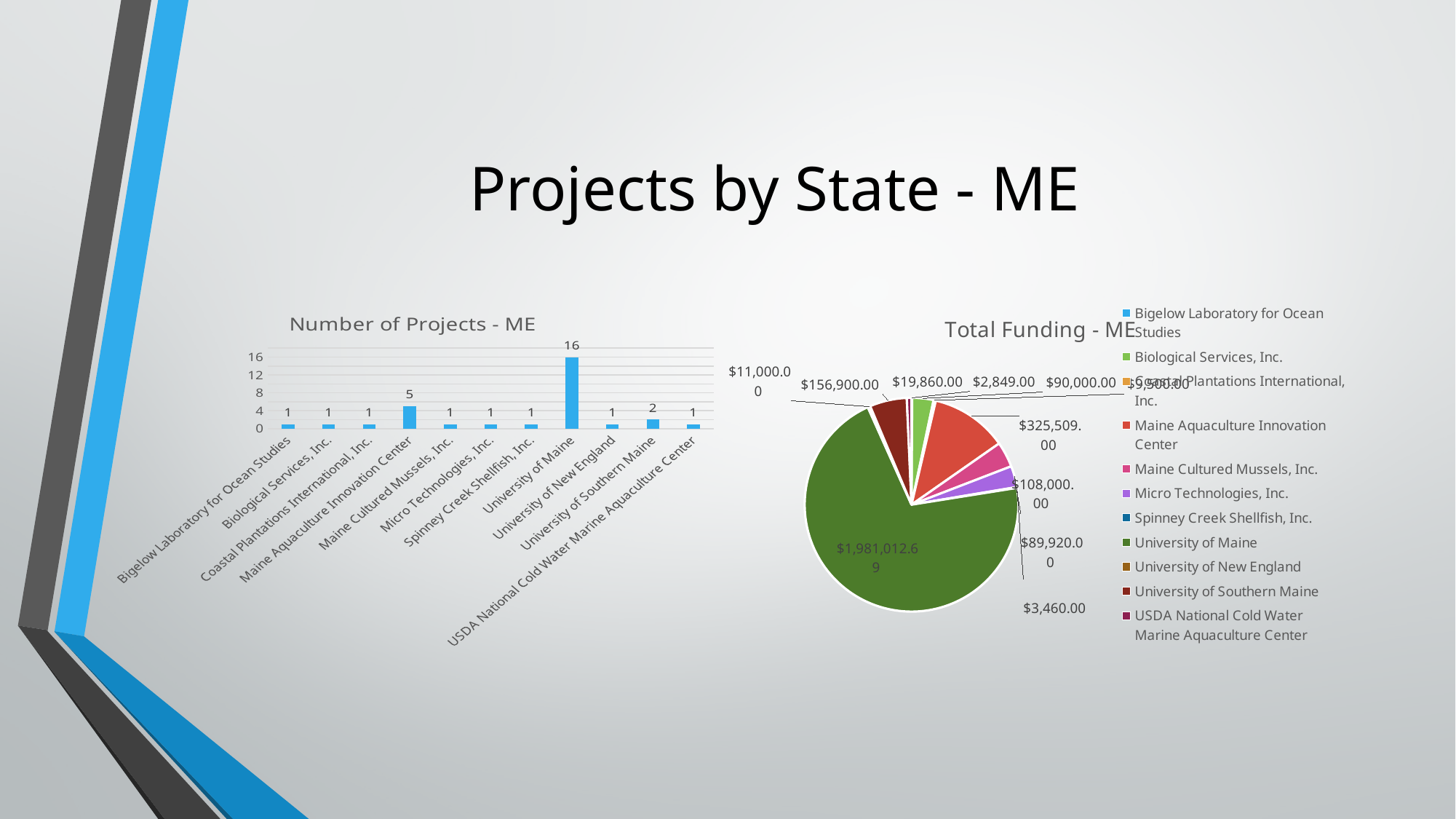
In the 'Number of Projects - ME' chart, which organization has the most projects? University of Maine In the 'Number of Projects - ME' chart, how many projects does the University of Maine have? 16 In the 'Total Funding - ME' chart, what is the total funding for the University of Maine? $1,981,012.69 In the 'Number of Projects - ME' chart, how many projects does the University of Southern Maine have? 2 What type of chart is 'Total Funding - ME'? Pie chart How many entries does the legend of the 'Total Funding - ME' chart list? 11 In the 'Number of Projects - ME' chart, how many projects does the Maine Aquaculture Innovation Center have? 5 How many organizations are shown in the 'Number of Projects - ME' chart? 11 In the 'Total Funding - ME' chart, which organization has the largest share of funding? University of Maine In the 'Number of Projects - ME' chart, which has more projects, the University of Southern Maine or the University of New England? University of Southern Maine What type of chart is 'Number of Projects - ME'? Bar chart In the 'Number of Projects - ME' chart, what is the difference in number of projects between the University of Maine and the Maine Aquaculture Innovation Center? 11